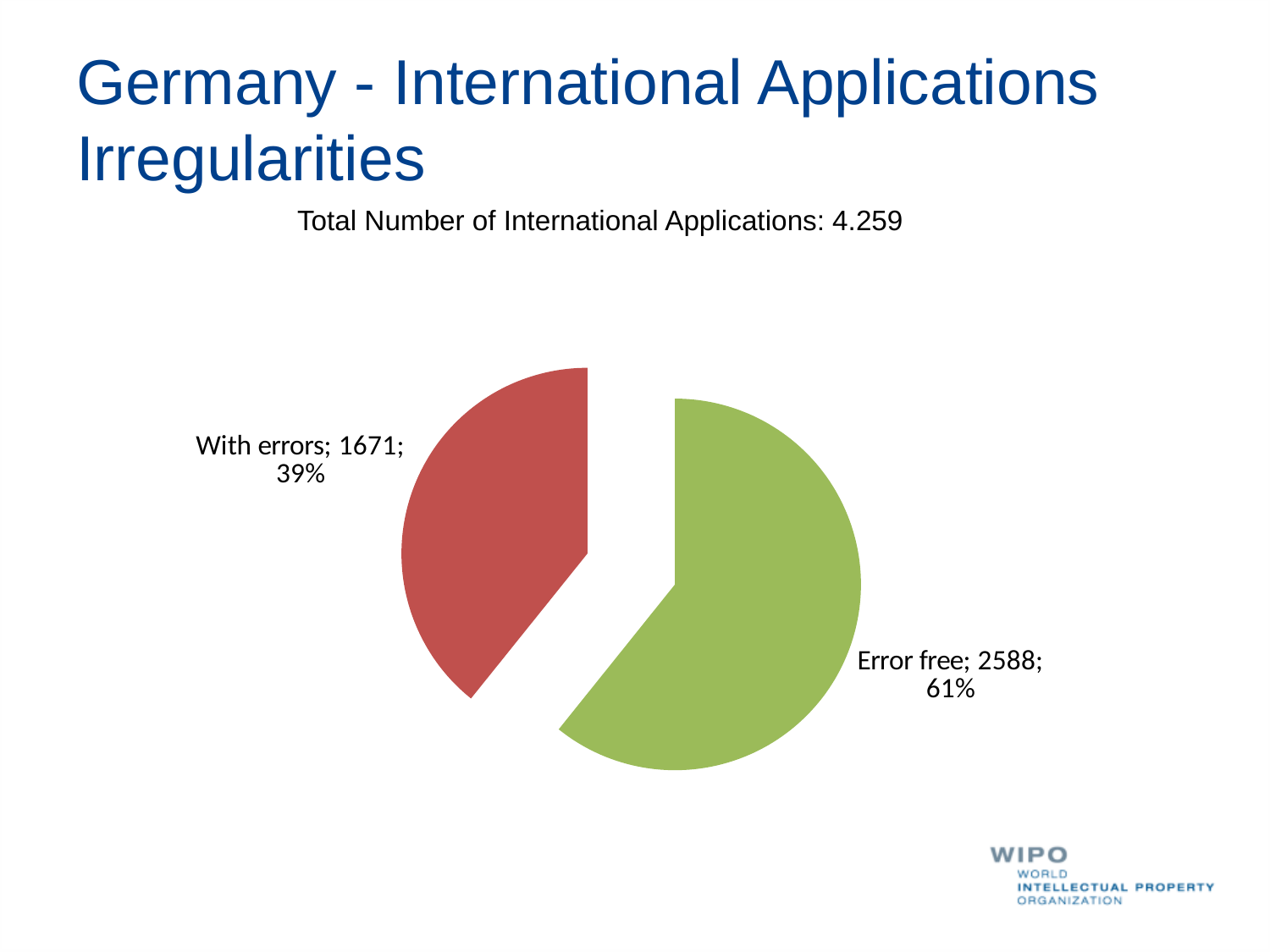
What share of the pie is the 'Error free' slice? 61% Which slice is the largest? Error free What kind of chart is shown on the slide? pie chart What total number of international applications is stated on the slide? 4.259 Which is larger, the number of error free applications or the number with errors? Error free What is the number of error free applications? 2588 How many slices does the pie chart have? 2 Which slice is the smallest? With errors What share of the pie is the 'With errors' slice? 39% What colour is the 'Error free' slice? green What is the number of applications with errors? 1671 What is the difference between the number of error free applications and the number with errors? 917